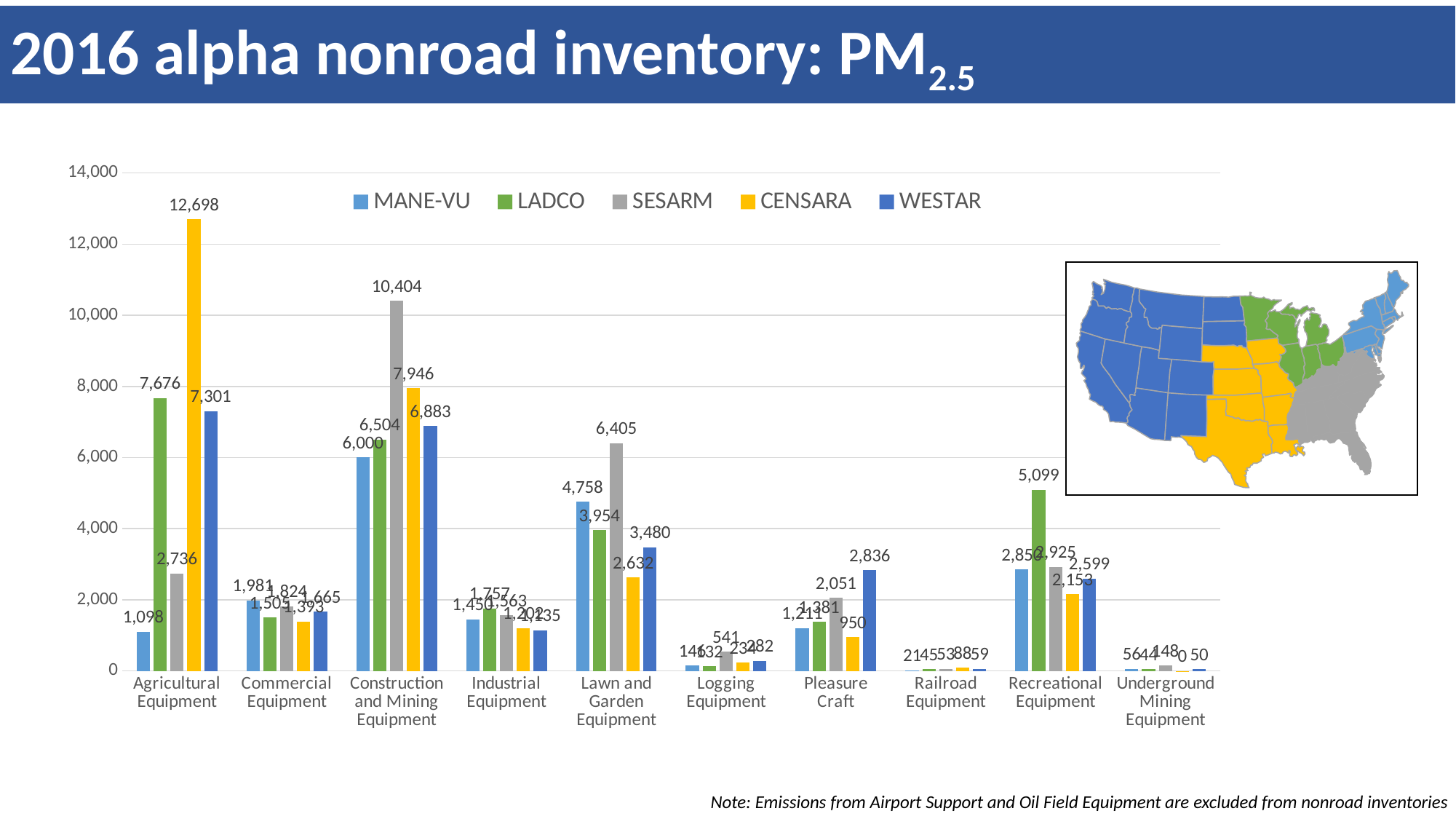
What is the WESTAR value for Pleasure Craft? 2,836 What is the SESARM value for Construction and Mining Equipment? 10,404 What is the CENSARA value for Agricultural Equipment? 12,698 How many equipment categories are shown on the x axis? 10 For Recreational Equipment, which is larger: the LADCO value or the WESTAR value? LADCO How many series does the legend list? 5 Which series has the highest value for Lawn and Garden Equipment? SESARM Which series has the lowest value for Pleasure Craft? CENSARA What kind of chart is shown on the slide? bar chart What is the difference between the SESARM and CENSARA values for Construction and Mining Equipment? 2,458 What is the difference between the CENSARA and LADCO values for Agricultural Equipment? 5,022 Is the WESTAR value for Railroad Equipment greater or less than 2,000? less